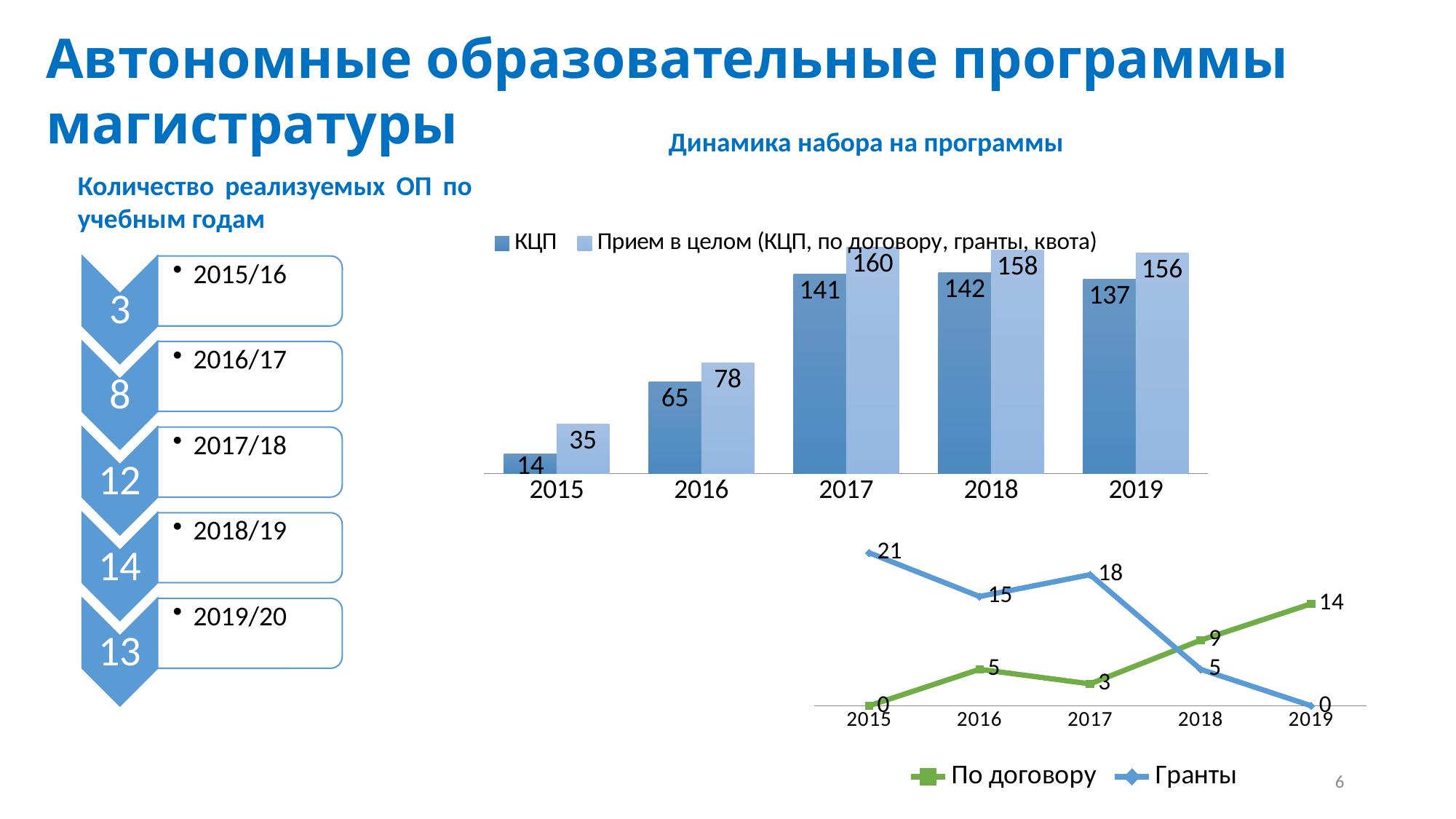
In the bar chart 'Динамика набора на программы', how many series does the legend list? 2 In the bar chart 'Динамика набора на программы', which year has the lowest value for КЦП? 2015 In the lower line chart, does the 'Гранты' series generally rise or fall from 2015 to 2019? fall In the bar chart 'Динамика набора на программы', what is the value of КЦП for 2017? 141 In the lower line chart, which series has the larger value in 2019, 'По договору' or 'Гранты'? По договору In the lower line chart, what is the value of 'По договору' for 2018? 9 What kind of chart is the lower chart on the slide, with the series 'По договору' and 'Гранты'? line chart In the bar chart 'Динамика набора на программы', which year has the highest value for 'Прием в целом'? 2017 In the bar chart 'Динамика набора на программы', how many years are shown on the x axis? 5 In the lower line chart, what is the value of 'Гранты' for 2017? 18 In the bar chart 'Динамика набора на программы', what is the value of 'Прием в целом' for 2016? 78 In the bar chart 'Динамика набора на программы', what is the difference between 'Прием в целом' and КЦП in 2019? 19